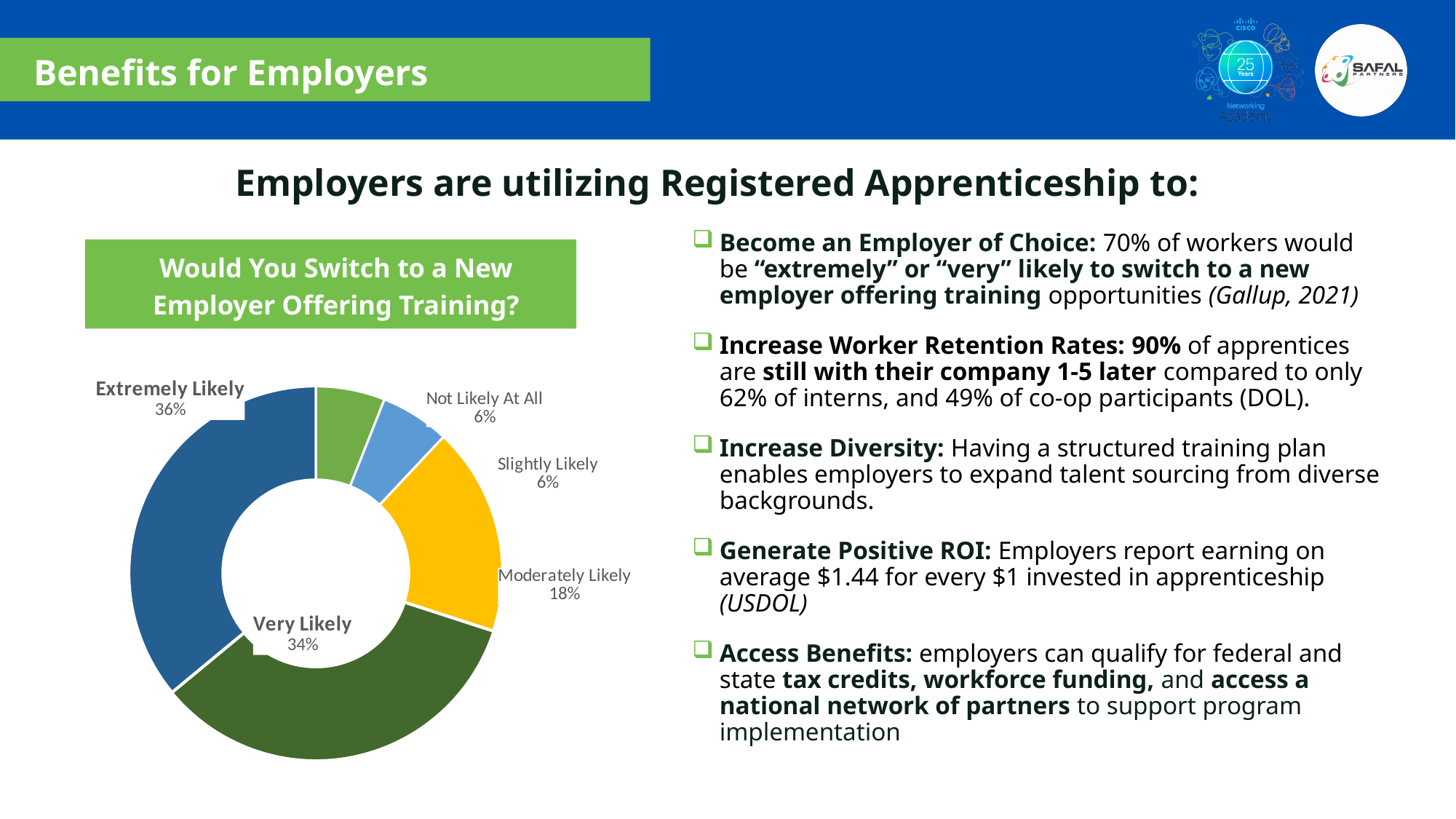
Which category has the largest share of the chart? Extremely Likely How many categories are shown in the chart? 5 What type of chart is shown on the slide? Doughnut (pie) chart Which is larger, the share for Extremely Likely or the share for Very Likely? Extremely Likely What percentage of respondents said they would be Very Likely to switch? 34% What is the title of the chart? Would You Switch to a New Employer Offering Training? What percentage is shown for Slightly Likely? 6% What is the combined share of Extremely Likely and Very Likely? 70% What share of the chart is labelled Moderately Likely? 18% What is the difference in percentage points between Extremely Likely and Moderately Likely? 18 What percentage is shown for Not Likely At All? 6% What percentage of respondents said they would be Extremely Likely to switch? 36%